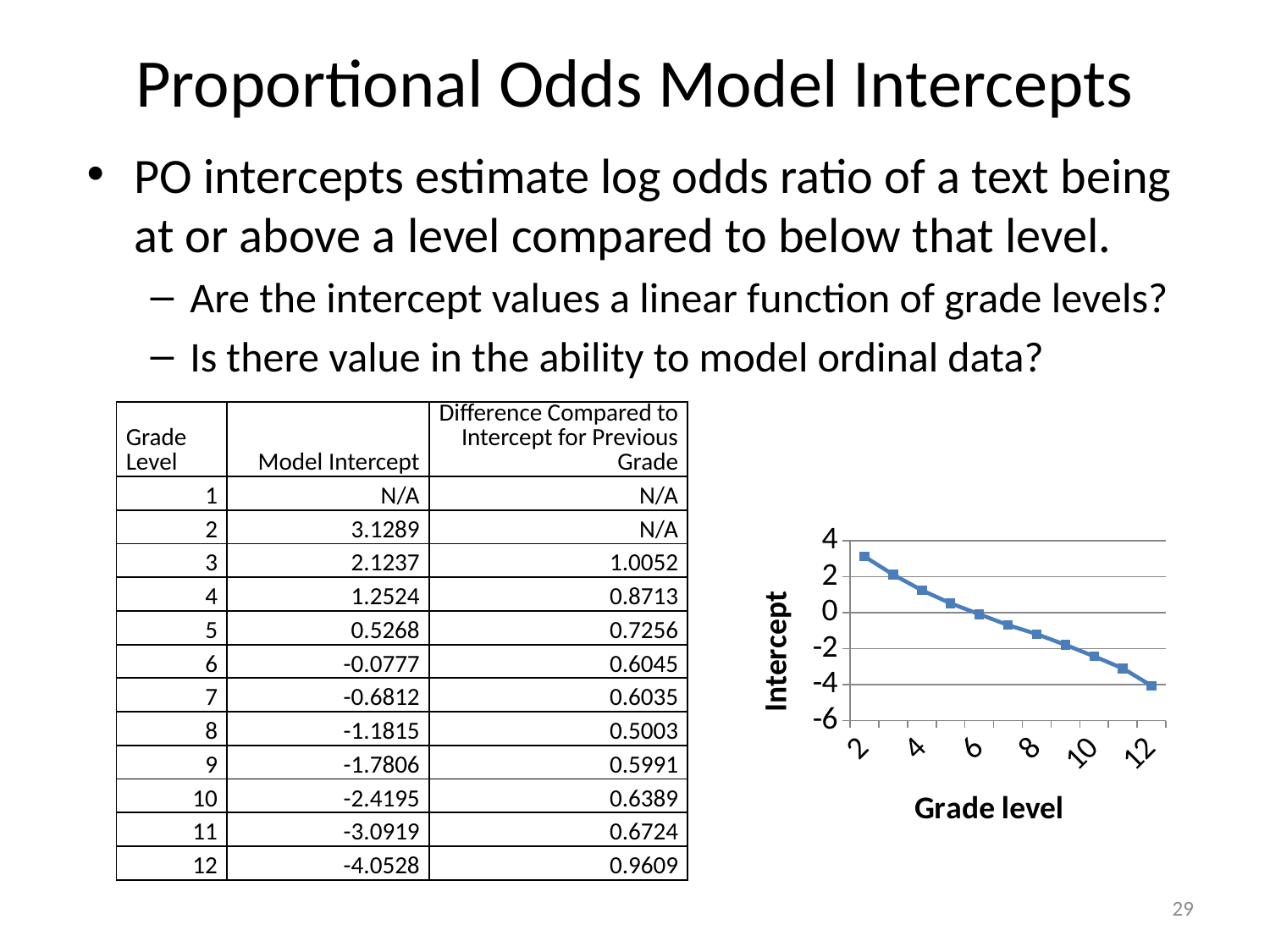
What kind of chart is shown on the slide? line chart Is the intercept for grade level 2 greater or less than 2? greater How many data points are plotted in the chart? 11 Do the intercept values rise or fall as grade level increases along the x axis? fall What is the title of the chart's vertical axis? Intercept Which grade level has the highest intercept in the chart? 2 Is the intercept for grade level 8 greater or less than 0? less What is the title of the chart's horizontal axis? Grade level Which has the larger intercept, grade level 4 or grade level 10? grade level 4 Which grade level has the lowest intercept in the chart? 12 According to the table on the slide, what is the model intercept for grade level 6? -0.0777